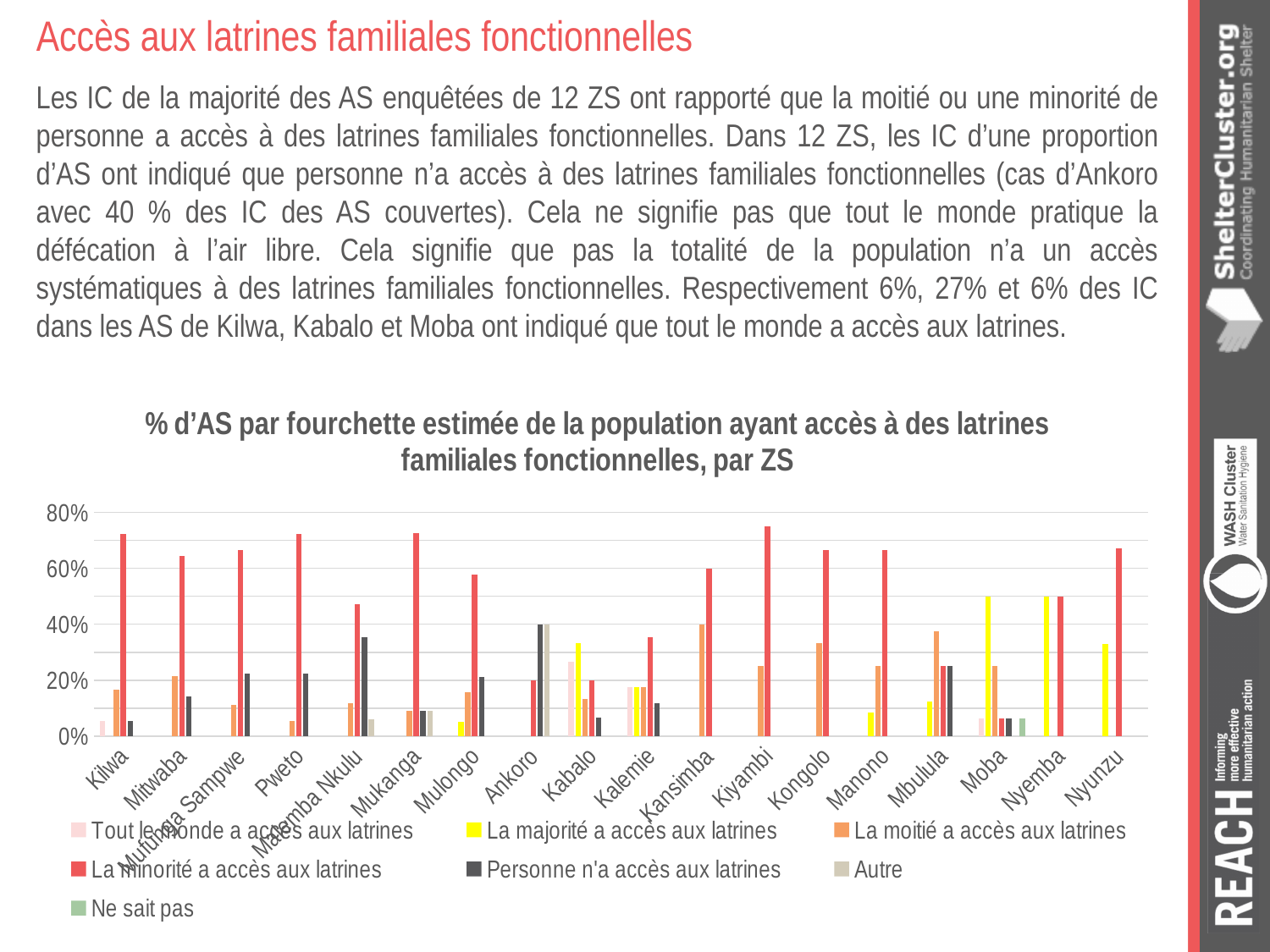
What colour represents 'La minorité a accès aux latrines' in the chart legend? red Is the value of 'La majorité a accès aux latrines' for Moba greater or less than 40%? greater Is the value of 'La minorité a accès aux latrines' for Kabalo greater or less than 40%? less Which ZS has the highest value for 'Personne n'a accès aux latrines'? Ankoro Which is larger: the 'Personne n'a accès aux latrines' value for Ankoro or for Kilwa? Ankoro What kind of chart is shown on the slide? bar chart How many ZS (categories) are shown along the x axis of the chart? 18 Is the value of 'La minorité a accès aux latrines' for Kiyambi greater or less than 60%? greater Which is larger: the 'La minorité a accès aux latrines' value for Kilwa or for Kabalo? Kilwa How many series does the chart legend list? 7